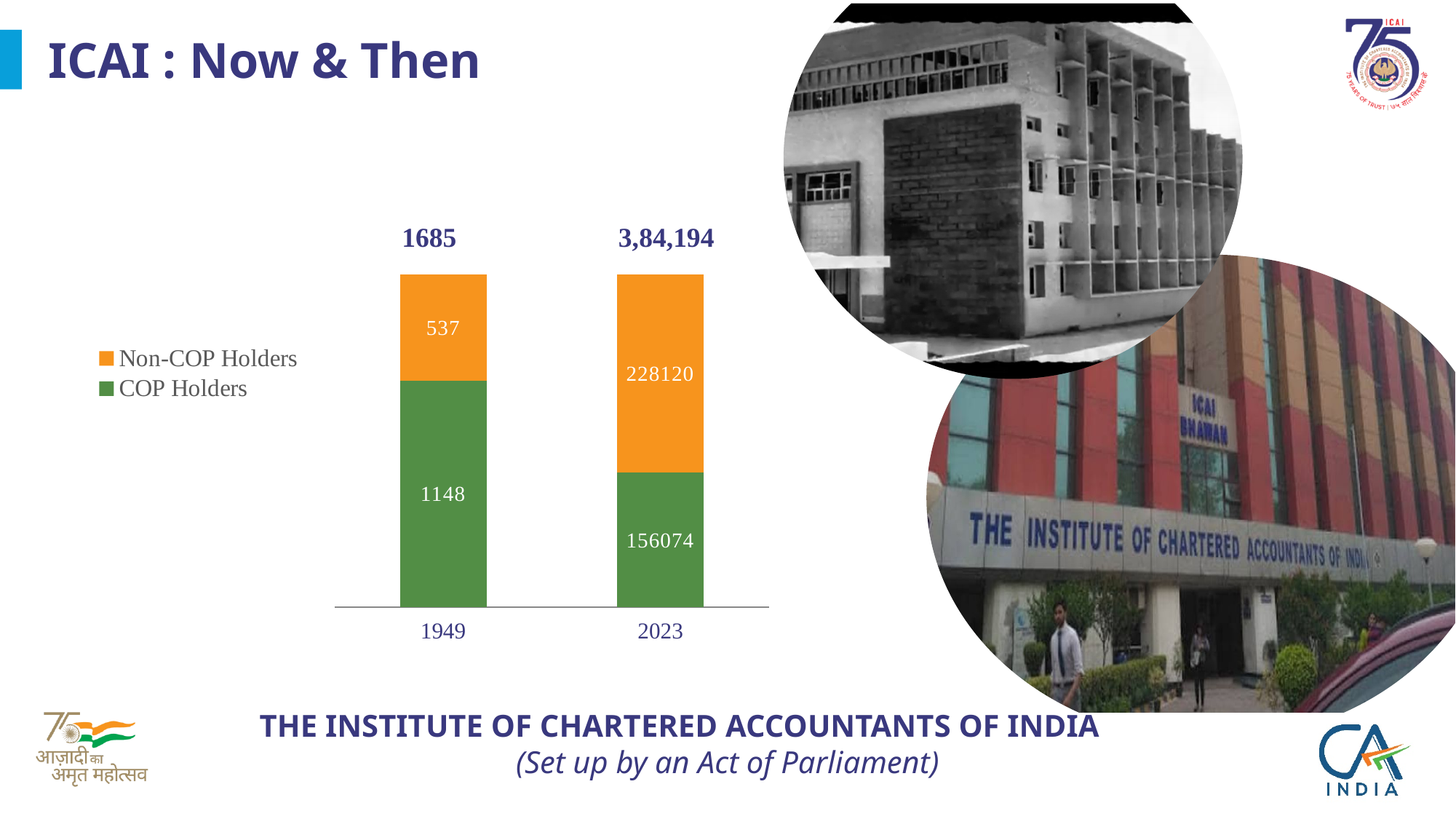
Which colour represents COP Holders in the chart? Green What is the difference between COP Holders and Non-COP Holders in 1949? 611 What is the value for COP Holders in 1949? 1148 What is the total shown above the 1949 bar? 1685 How many series does the chart legend list? 2 What is the total shown above the 2023 bar? 3,84,194 What is the value for Non-COP Holders in 1949? 537 In 2023, which is larger: COP Holders or Non-COP Holders? Non-COP Holders What kind of chart is shown on the slide? Stacked bar chart What is the value for Non-COP Holders in 2023? 228120 How many categories are shown on the x axis of the chart? 2 What is the value for COP Holders in 2023? 156074